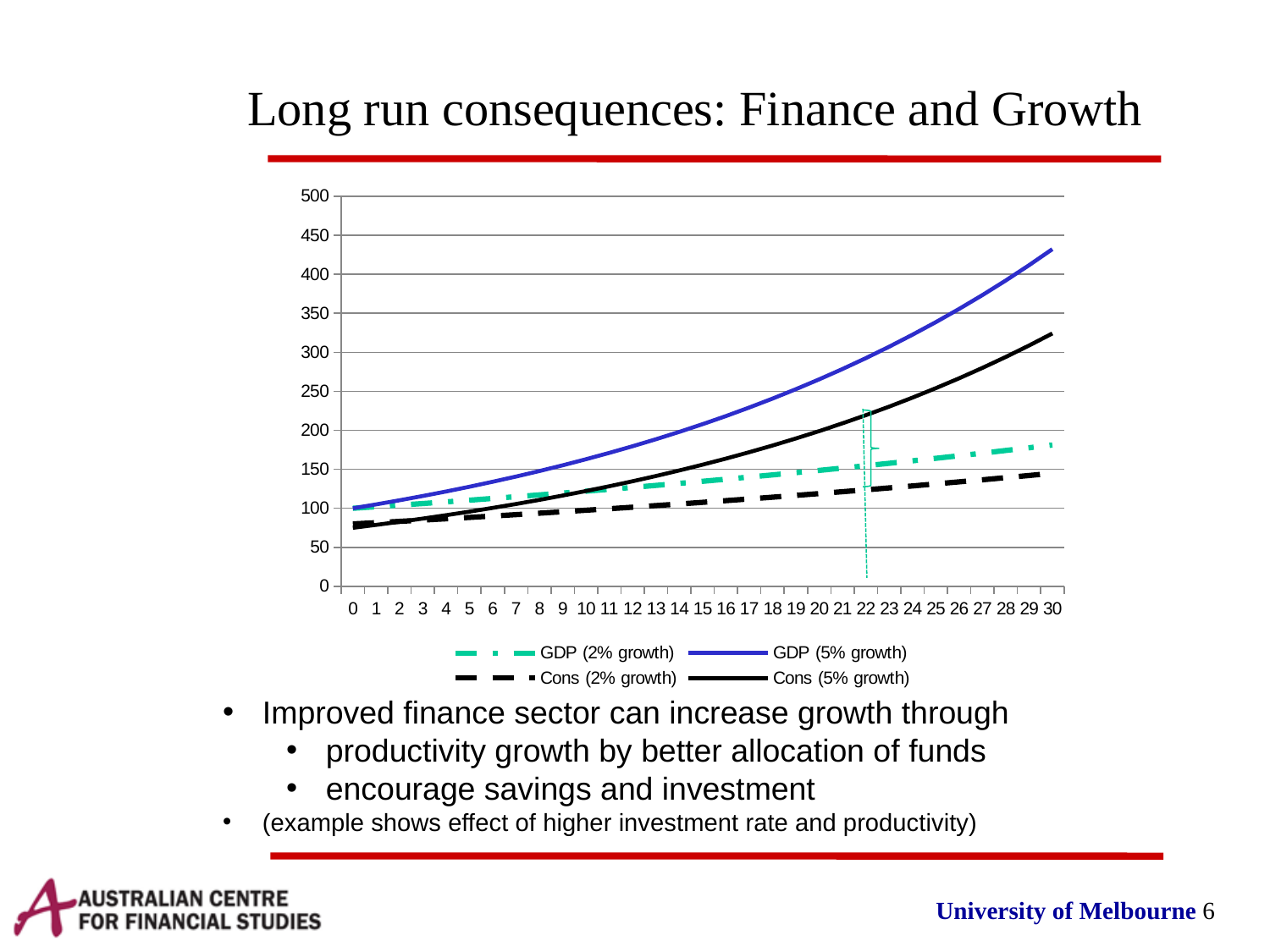
Is the value for GDP (5% growth) at period 30 greater or less than 400? greater Which series has the lowest value at period 30? Cons (2% growth) What is the title of the slide containing the chart? Long run consequences: Finance and Growth How many series does the chart's legend list? 4 Do the values of GDP (5% growth) rise or fall as the period increases from 0 to 30? rise At period 30, which is larger: Cons (5% growth) or GDP (2% growth)? Cons (5% growth) What is the value of GDP (5% growth) at period 0? 100 Which series has the highest value at period 30? GDP (5% growth) What kind of chart is shown on the slide? line chart What is the value of GDP (2% growth) at period 0? 100 Is the value for Cons (5% growth) at period 30 greater or less than 300? greater Is the value for GDP (2% growth) at period 30 greater or less than 200? less